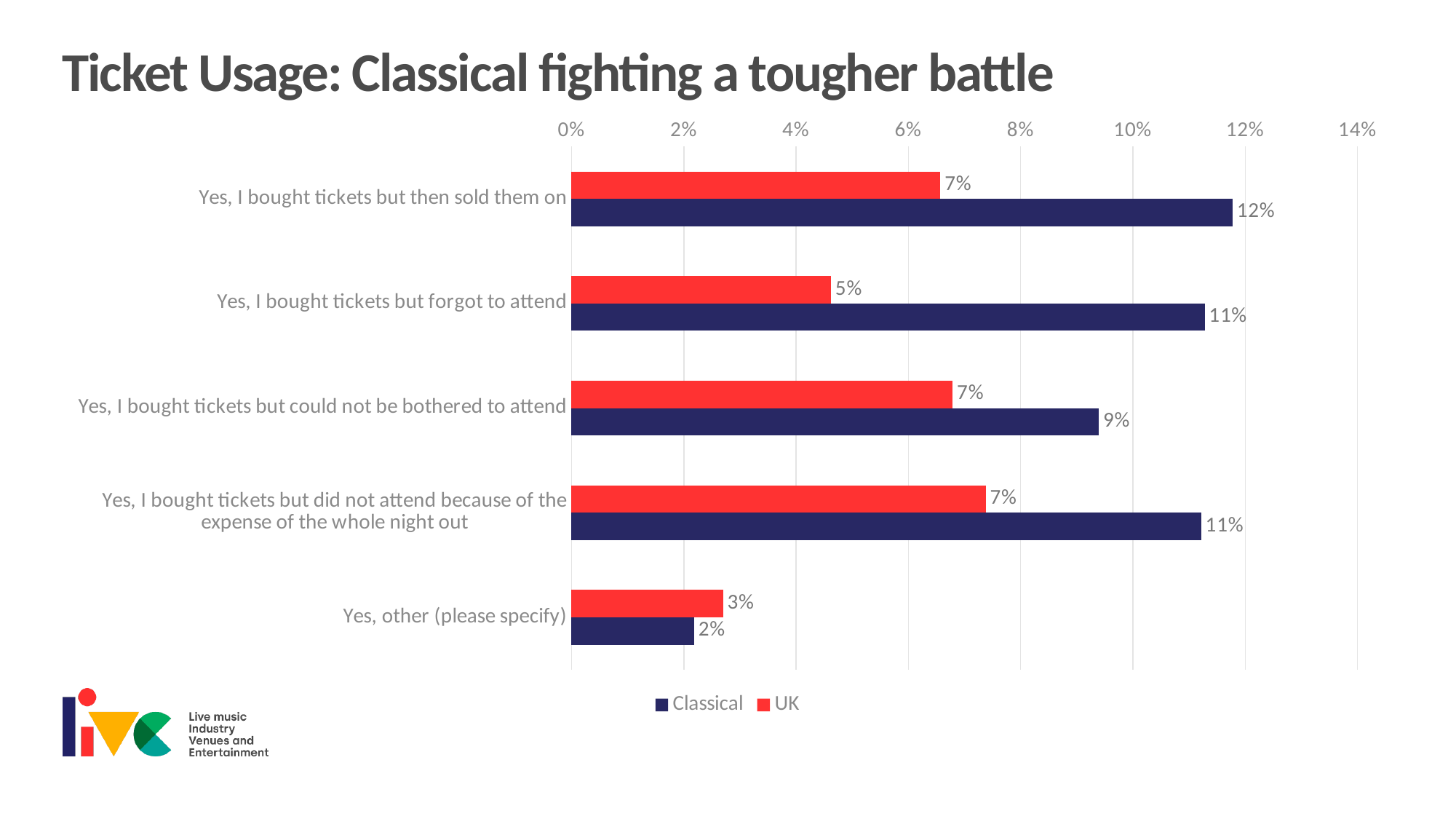
What type of chart is shown on the slide? Bar chart What is the Classical value for "Yes, I bought tickets but then sold them on"? 12% What is the Classical value for "Yes, I bought tickets but could not be bothered to attend"? 9% For "Yes, other (please specify)", which is larger, the Classical value or the UK value? UK What is the UK value for "Yes, I bought tickets but forgot to attend"? 5% What is the UK value for "Yes, other (please specify)"? 3% Is the Classical value for "Yes, I bought tickets but did not attend because of the expense of the whole night out" greater or less than 10%? greater Which category has the lowest UK value? Yes, other (please specify) What is the difference between the Classical and UK values for "Yes, I bought tickets but forgot to attend"? 6 percentage points Which category has the highest Classical value? Yes, I bought tickets but then sold them on How many categories are shown on the chart? 5 How many series does the legend list? 2